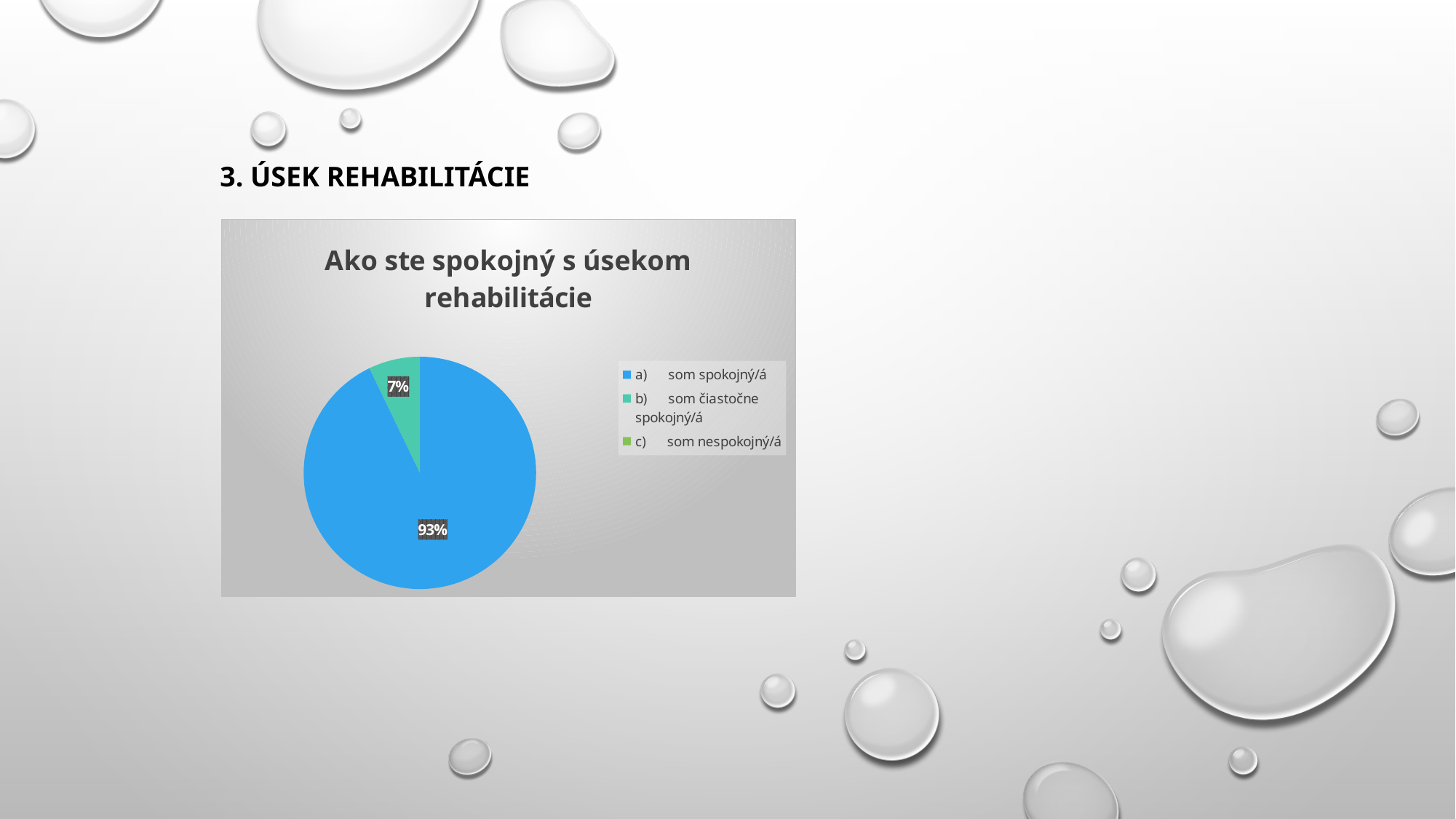
What kind of chart is shown on the slide? pie chart How many entries does the legend list? 3 What is the difference in percentage points between the "a) som spokojný/á" slice and the "b) som čiastočne spokojný/á" slice? 86 Which category has the largest slice of the pie? a) som spokojný/á How many percentage labels are printed on the pie? 2 What share of the pie is labelled for "a) som spokojný/á"? 93% What share of the pie is labelled for "b) som čiastočne spokojný/á"? 7% What is the title of the chart? Ako ste spokojný s úsekom rehabilitácie Which is larger, the slice for "a) som spokojný/á" or the slice for "b) som čiastočne spokojný/á"? a) som spokojný/á What colour is the slice for "a) som spokojný/á"? blue